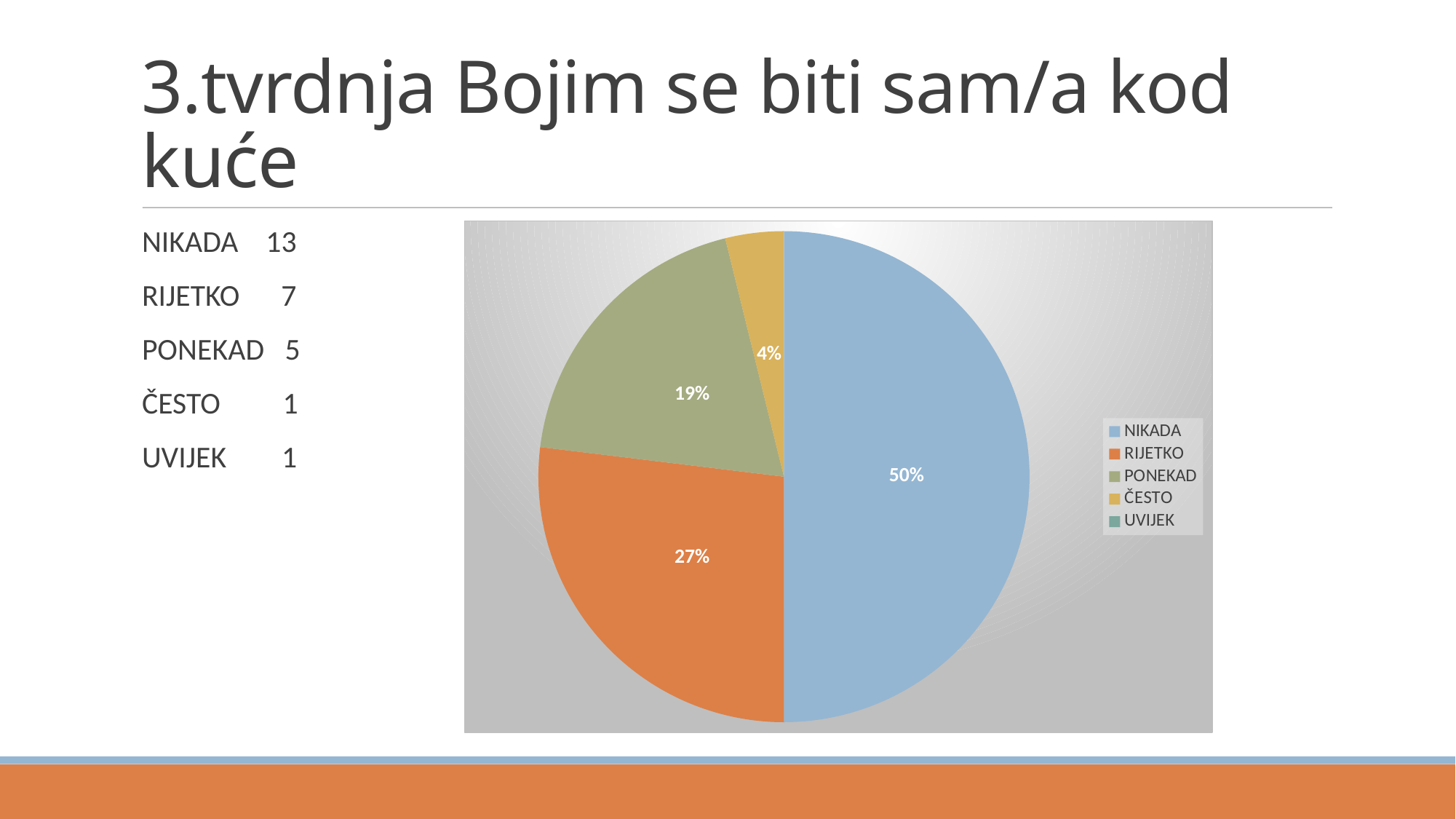
What percentage is shown on the ČESTO slice of the pie chart? 4% What type of chart is shown on the slide? Pie chart What percentage is shown on the PONEKAD slice of the pie chart? 19% How many entries does the legend of the pie chart list? 5 Which of the labelled slices in the pie chart is the smallest? ČESTO What percentage is shown on the RIJETKO slice of the pie chart? 27% What share of the pie does the NIKADA slice take up? 50% Which category has the largest slice in the pie chart? NIKADA Which slice is larger in the pie chart, RIJETKO or PONEKAD? RIJETKO What colour is the NIKADA slice in the pie chart? Blue By how many percentage points is the NIKADA slice larger than the RIJETKO slice? 23 percentage points What percentage of the pie chart does the NIKADA slice represent? 50%